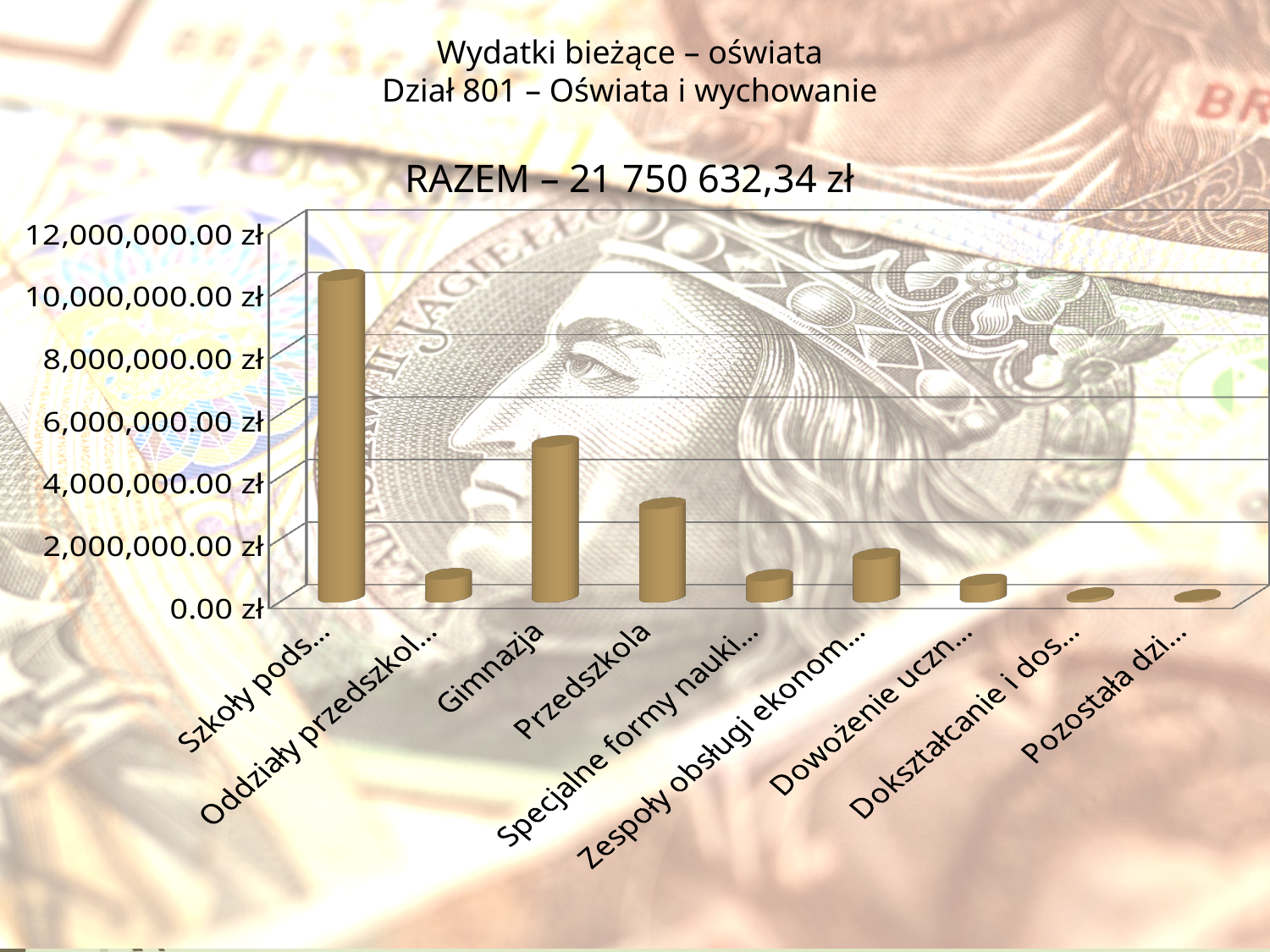
What is the highest value shown on the vertical axis? 12,000,000.00 zł What total amount (RAZEM) is stated in the chart title? 21 750 632,34 zł Which is larger, the value for Gimnazja or the value for Przedszkola? Gimnazja Is the value for Przedszkola greater or less than 2,000,000.00 zł? greater Which is larger, the value for Przedszkola or the value for Dowożenie uczn...? Przedszkola Which category has the highest value on the chart? Szkoły pods... How many categories are plotted on the chart? 9 What kind of chart is shown on the slide? bar chart Is the value for Gimnazja greater or less than 6,000,000.00 zł? less Is the value for Szkoły pods... greater or less than 10,000,000.00 zł? greater Which is larger, the value for Zespoły obsługi ekonom... or the value for Oddziały przedszkol...? Zespoły obsługi ekonom...